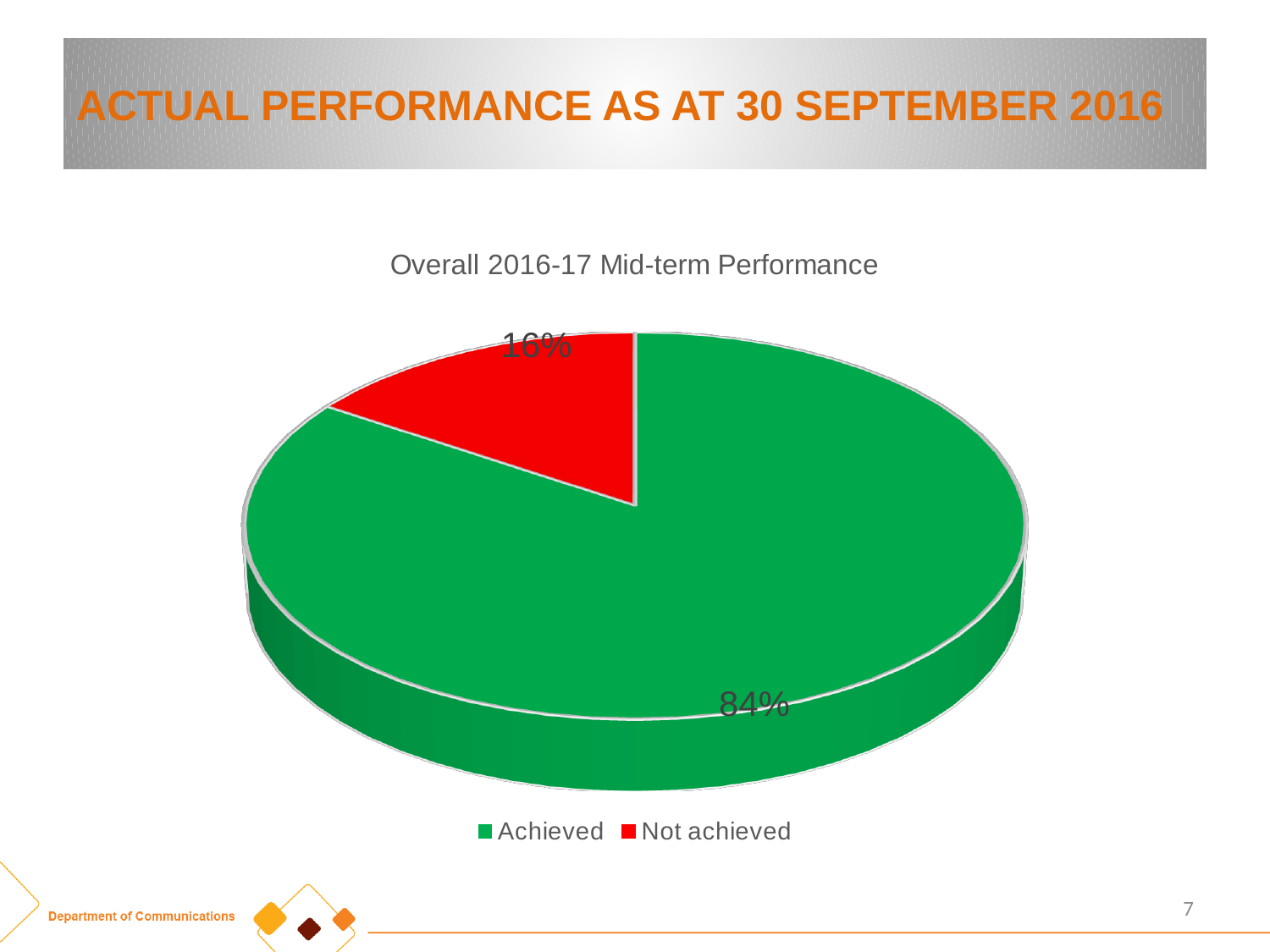
Which is larger, the Achieved slice or the Not achieved slice? Achieved What share of the pie does the Achieved slice represent? 84% What type of chart is shown on the slide? Pie chart Which slice is the largest? Achieved What colour is the Not achieved slice? Red What percentage of the pie is labelled Not achieved? 16% What is the difference in percentage points between the Achieved and Not achieved slices? 68 How many slices does the pie chart have? 2 How many entries does the legend list? 2 What percentage of the pie is labelled Achieved? 84% Which slice is the smallest? Not achieved What is the chart's title? Overall 2016-17 Mid-term Performance